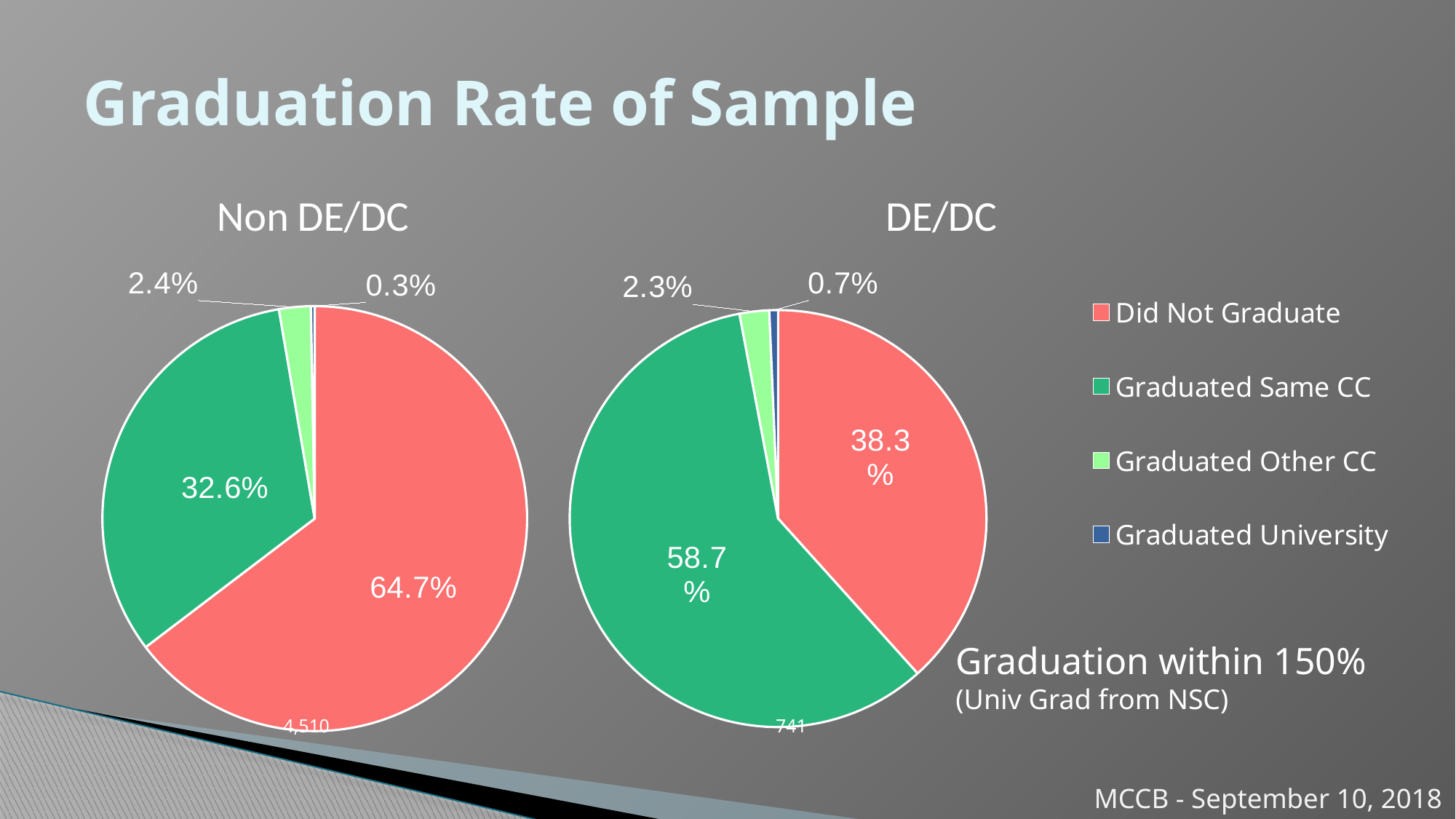
Which colour represents Graduated University in the legend? Dark blue In the Non DE/DC pie chart, what percentage Graduated Other CC? 2.4% What is the difference between the Did Not Graduate share in the Non DE/DC chart and in the DE/DC chart? 26.4% Which chart has the larger Graduated Same CC share, Non DE/DC or DE/DC? DE/DC What type of chart is used for the DE/DC data? Pie chart How many slices does the Non DE/DC pie chart have? 4 In the DE/DC pie chart, which category has the largest share? Graduated Same CC In the DE/DC pie chart, what percentage Graduated Same CC? 58.7% How many categories does the legend list? 4 In the DE/DC pie chart, what percentage Graduated University? 0.7% In the Non DE/DC pie chart, which category has the smallest share? Graduated University In the Non DE/DC pie chart, what percentage of the sample Did Not Graduate? 64.7%